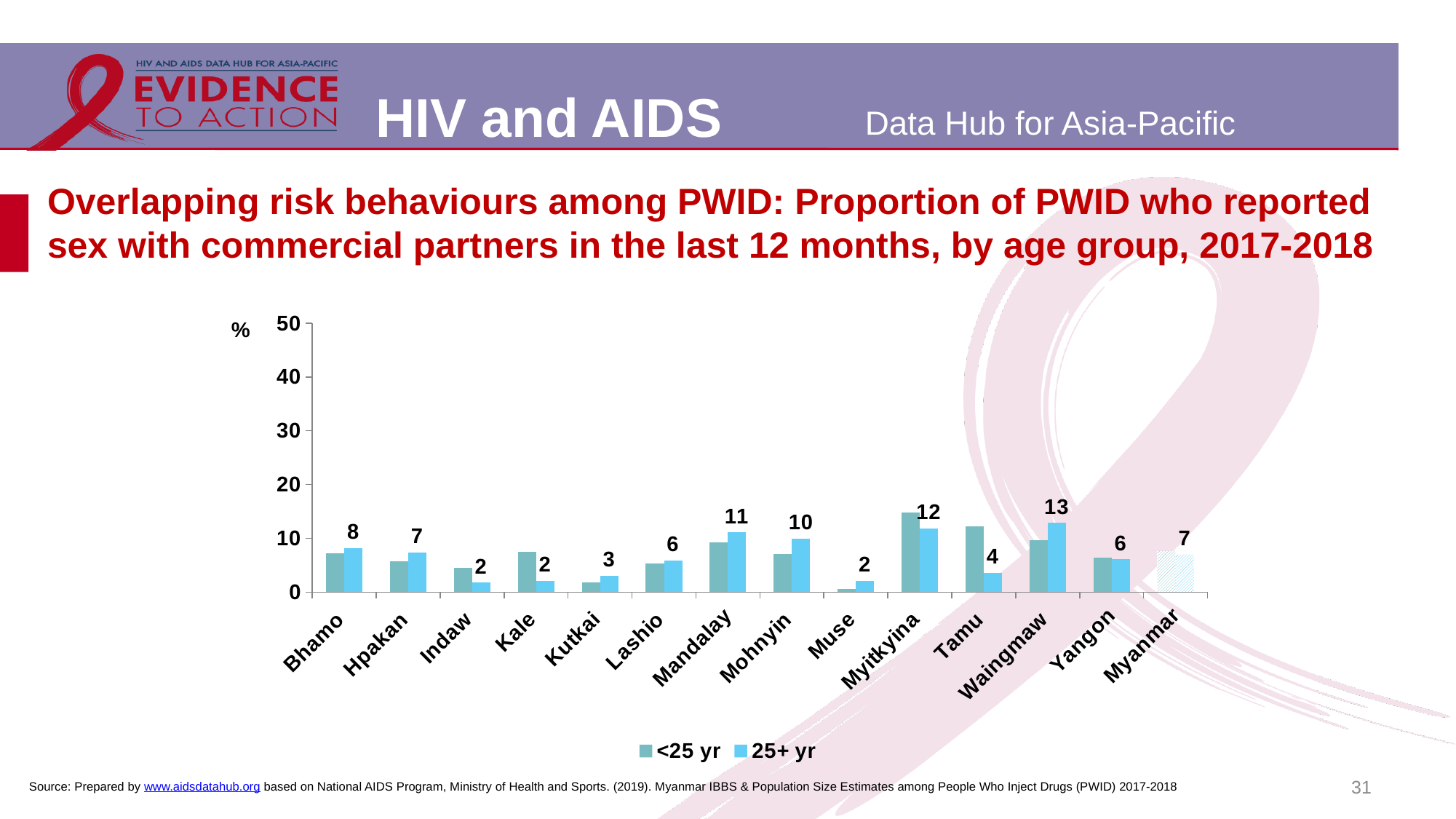
How many locations are shown on the x axis of the chart? 14 What is the difference between the 25+ yr values for Waingmaw and Tamu? 9 Is the value for the <25 yr series for Muse greater or less than 10? less What kind of chart is shown on the slide? Bar chart For Tamu, which age group has the larger value: <25 yr or 25+ yr? <25 yr Which location has the highest value for the 25+ yr series? Waingmaw Is the value for the <25 yr series for Myitkyina greater or less than 10? greater How many series does the legend list? 2 Which is larger for the 25+ yr series: Myitkyina or Mohnyin? Myitkyina What is the value for the 25+ yr series for Waingmaw? 13 What is the value for the 25+ yr series for Myanmar? 7 What is the value for the 25+ yr series for Mandalay? 11